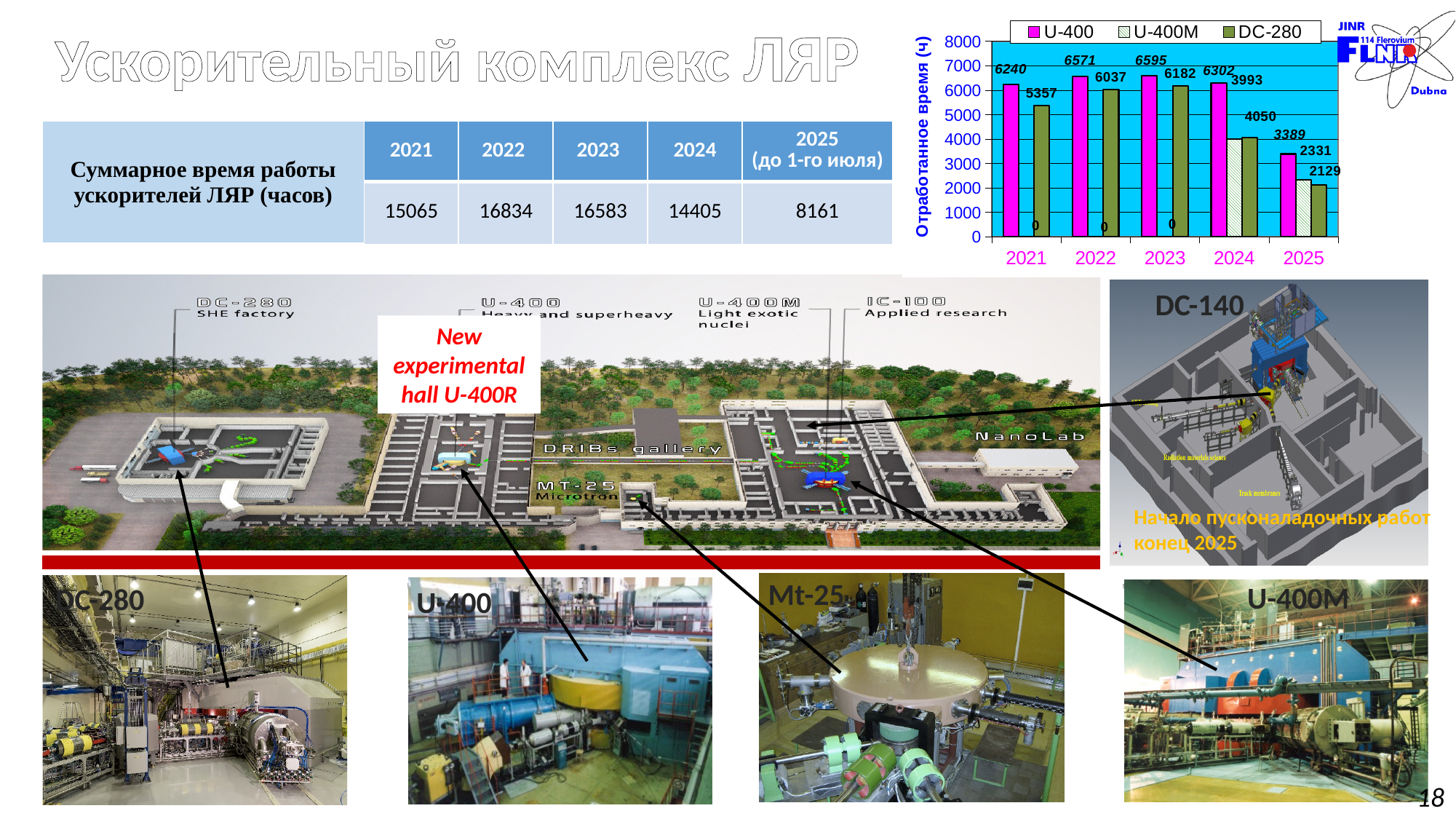
How many years are shown on the x axis of the bar chart? 5 What is the value for U-400M in 2024 in the bar chart? 3993 What is the value for DC-280 in 2023 in the bar chart? 6182 What is the value for U-400M in 2021 in the bar chart? 0 What is the label of the vertical axis of the bar chart? Отработанное время (ч) What is the value for U-400 in 2021 in the bar chart? 6240 In which year is the DC-280 value lowest in the bar chart? 2025 In which year does U-400 reach its highest value in the bar chart? 2023 What is the difference between the U-400 and DC-280 values in 2022 in the bar chart? 534 What type of chart is shown in the top right of the slide? bar chart In 2024, which is larger in the bar chart: U-400M or DC-280? DC-280 How many series does the legend of the bar chart list? 3